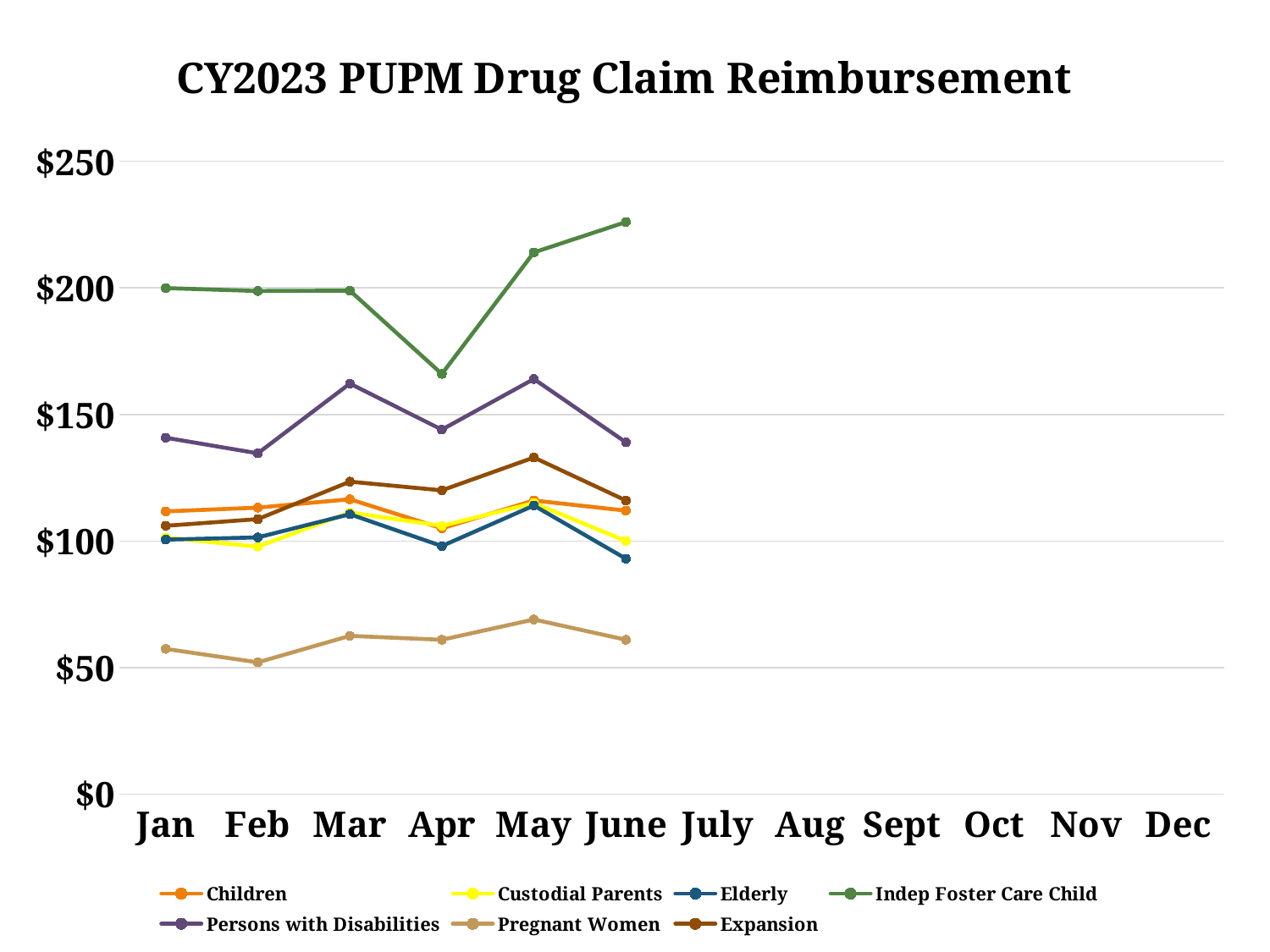
What is the title of the chart? CY2023 PUPM Drug Claim Reimbursement Is the value for Pregnant Women in Feb greater or less than $50? greater Which series has the lowest value in May? Pregnant Women What kind of chart is shown on the slide? line chart How many series does the legend list? 7 Which is larger in Apr: the value for Expansion or the value for Children? Expansion How many months have plotted data points? 6 Is the value for Persons with Disabilities in Mar greater or less than $150? greater Does the Indep Foster Care Child line rise or fall from Apr to June? rise Which series has the highest value in June? Indep Foster Care Child Is the value for Indep Foster Care Child in June greater or less than $200? greater